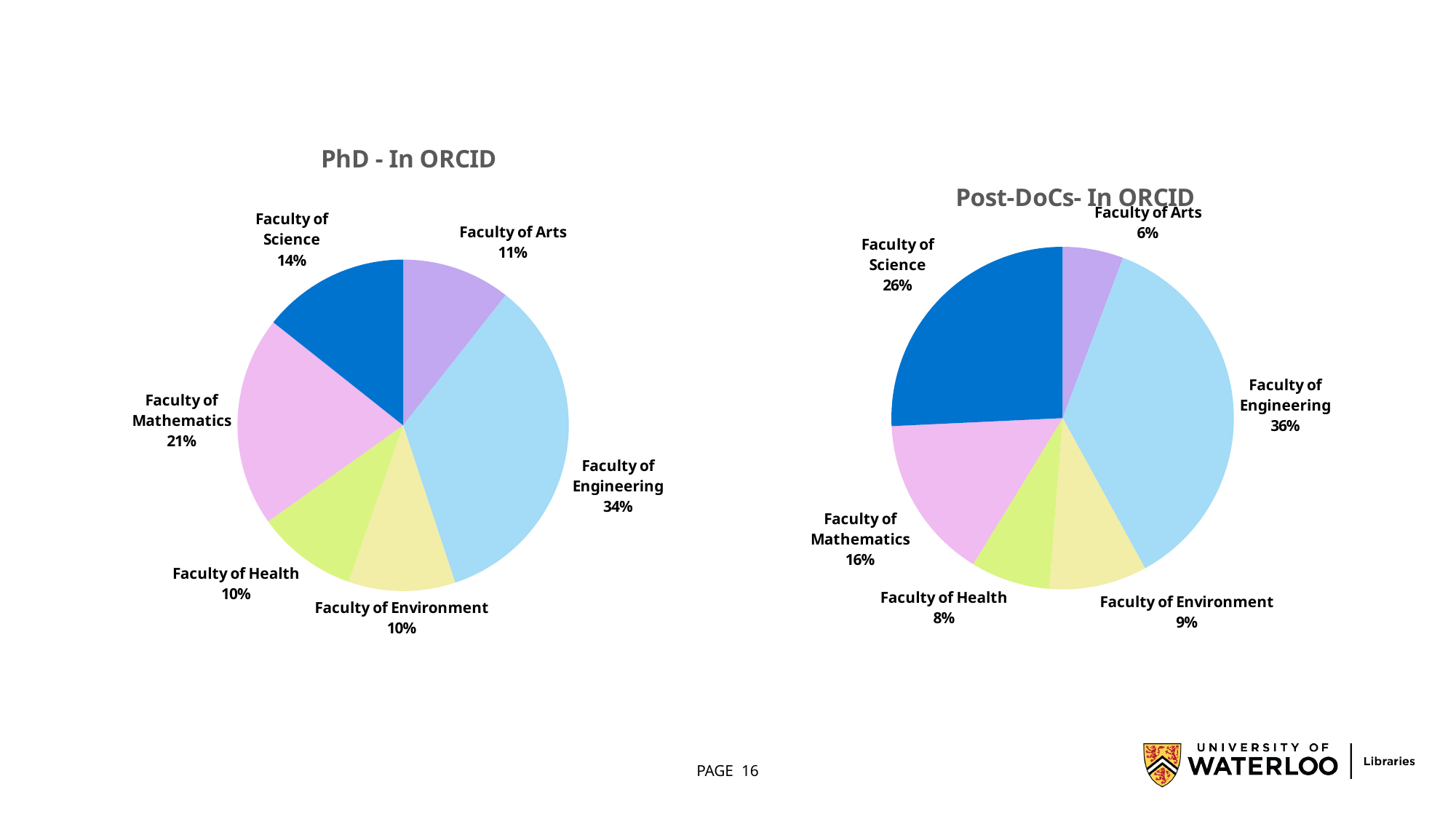
In the 'PhD - In ORCID' chart, what is the difference between the Faculty of Mathematics share and the Faculty of Science share? 7% In the 'Post-DoCs- In ORCID' chart, what share does the Faculty of Health have? 8% What is the title of the chart on the left side of the slide? PhD - In ORCID In the 'Post-DoCs- In ORCID' chart, what share does the Faculty of Science have? 26% What kind of chart is 'Post-DoCs- In ORCID'? Pie chart How many faculties are shown in the 'PhD - In ORCID' chart? 6 In the 'PhD - In ORCID' chart, which is larger: the Faculty of Arts share or the Faculty of Science share? Faculty of Science In the 'PhD - In ORCID' chart, which faculty has the largest slice? Faculty of Engineering In the 'PhD - In ORCID' chart, what share does the Faculty of Engineering have? 34% In the 'Post-DoCs- In ORCID' chart, which faculty has the smallest slice? Faculty of Arts In the 'Post-DoCs- In ORCID' chart, what is the difference between the Faculty of Engineering share and the Faculty of Mathematics share? 20% In the 'Post-DoCs- In ORCID' chart, which is larger: the Faculty of Environment share or the Faculty of Health share? Faculty of Environment